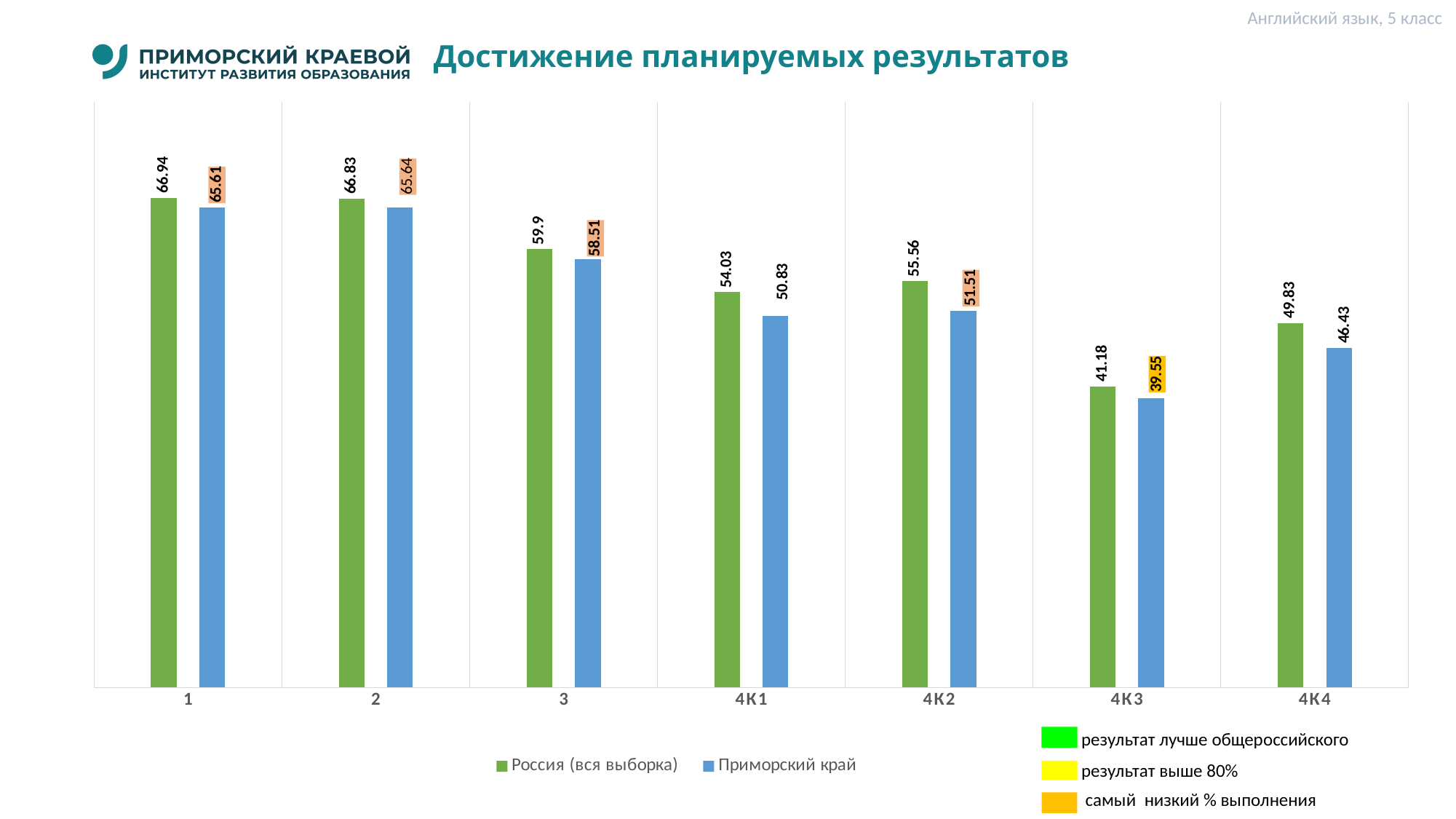
Which category has the lowest value for Приморский край? 4К3 What is the difference between Россия (вся выборка) and Приморский край in category 4К2? 4.05 What is the title of the chart on the slide? Достижение планируемых результатов Which is larger in category 4К1: Россия (вся выборка) or Приморский край? Россия (вся выборка) What is the value for Приморский край in category 4К1? 50.83 How many categories are shown on the x axis? 7 What is the difference between Россия (вся выборка) and Приморский край in category 4К4? 3.4 How many series does the chart legend list? 2 What is the value for Приморский край in category 4К3? 39.55 What kind of chart is shown on the slide? bar chart What is the value for Россия (вся выборка) in category 3? 59.9 Which category has the highest value for Россия (вся выборка)? 1